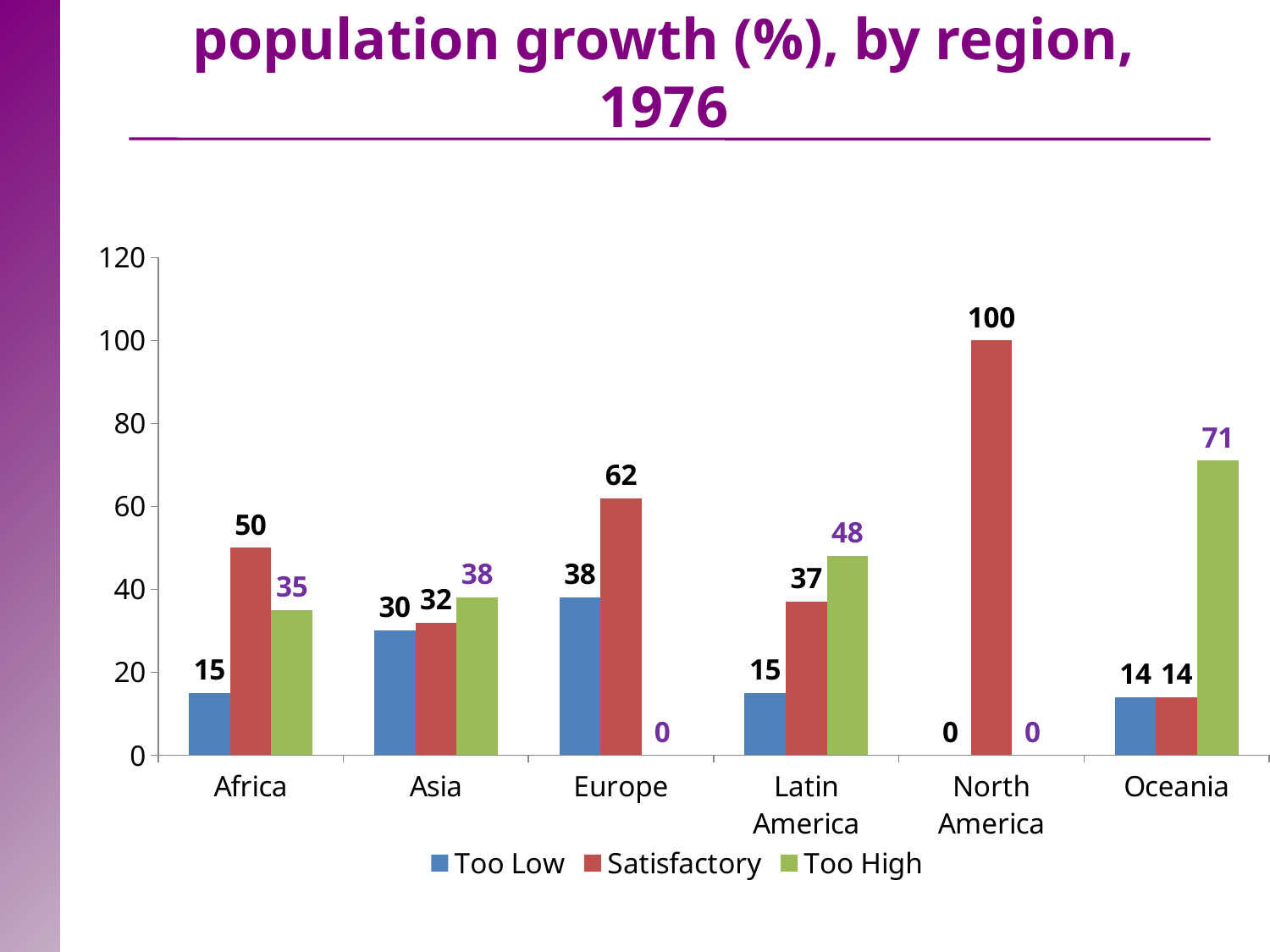
Which is larger for Latin America, the Satisfactory value or the Too High value? Too High Which region has the lowest Too Low value? North America What is the difference between the Satisfactory and Too Low values for Africa? 35 Which region has the highest Too High value? Oceania What is the Too High value for Oceania? 71 Which series is shown in green in the legend? Too High What is the Satisfactory value for North America? 100 What is the difference between the Too High values for Oceania and Asia? 33 What is the Too Low value for Europe? 38 How many series does the legend list? 3 What kind of chart is shown on the slide? Bar chart How many regions are shown on the x axis? 6